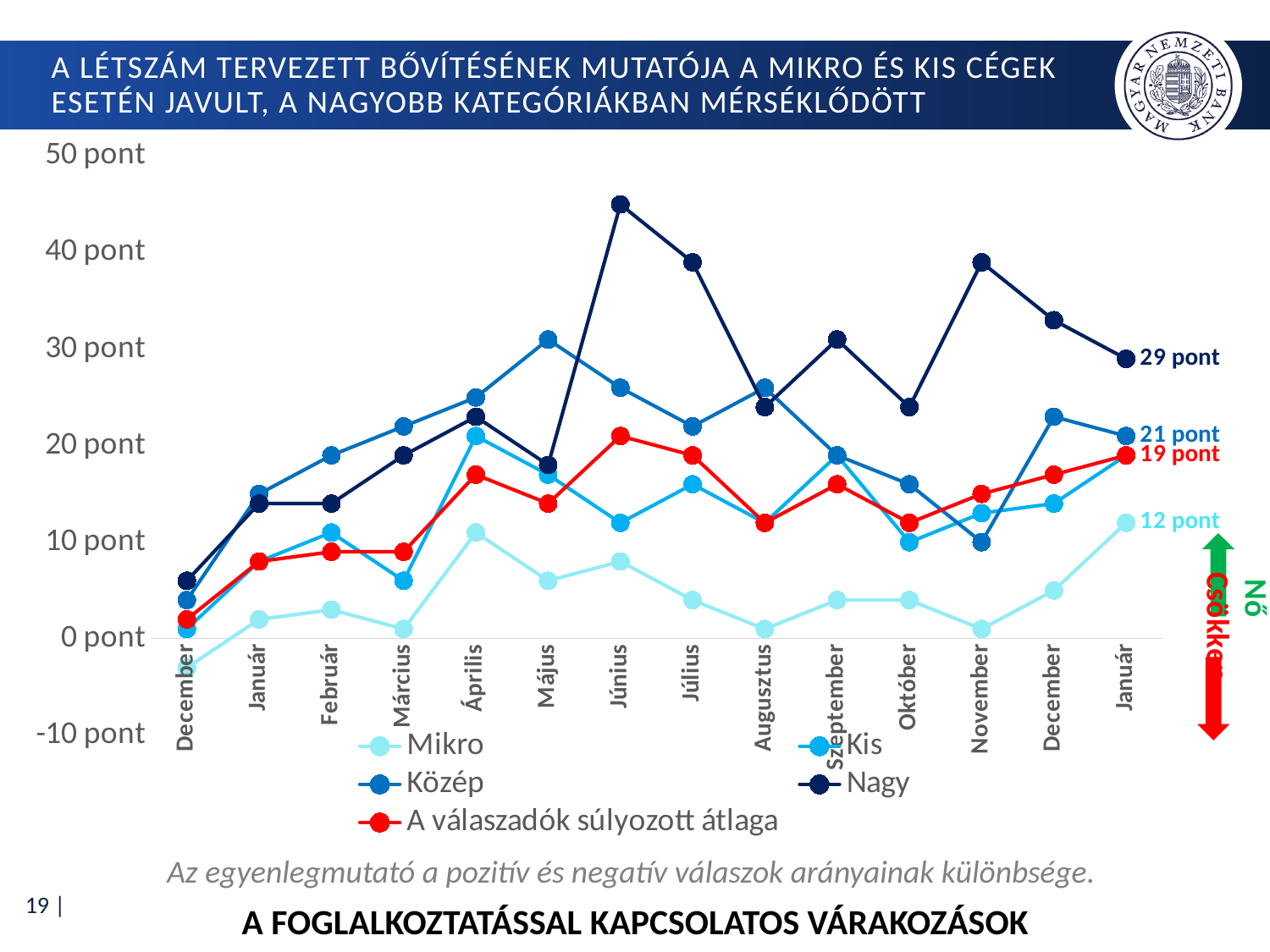
What is the value for Közép in the final Január? 21 pont Which series has the highest value in the final Január? Nagy What is the value for Nagy in the final Január? 29 pont How many months are shown along the x axis? 14 What is the difference between the Nagy and Mikro values in the final Január? 17 pont What is the value for Mikro in the final Január? 12 pont Which series has the lowest value in the final Január? Mikro What is the value of A válaszadók súlyozott átlaga in the final Január? 19 pont How many series does the legend list? 5 What is the title printed below the chart? A FOGLALKOZTATÁSSAL KAPCSOLATOS VÁRAKOZÁSOK Is the value for Nagy in Június greater or less than 40 pont? greater What kind of chart is shown on the slide? line chart